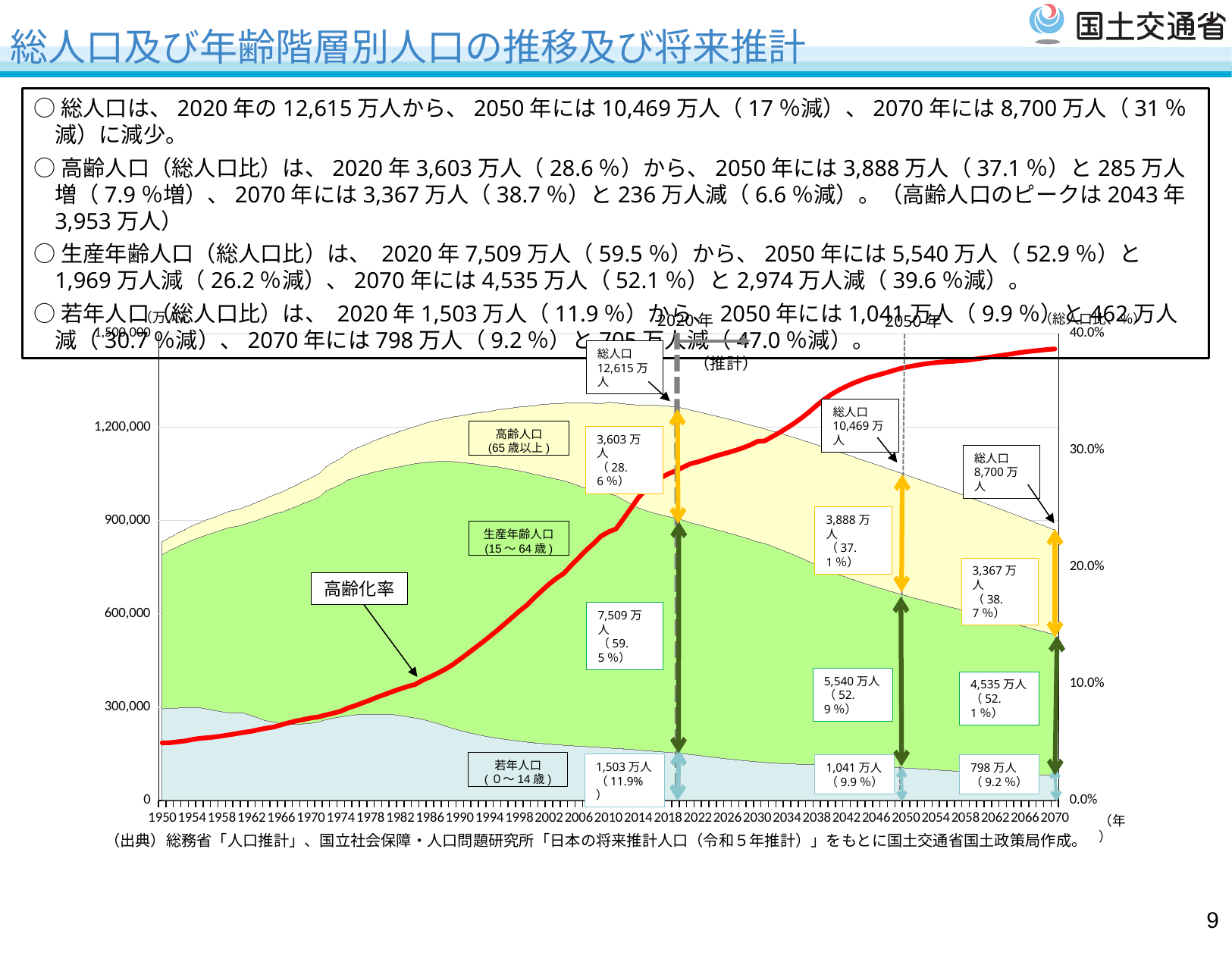
このグラフで、2070年の若年人口（0～14歳）として示されている値は何ですか？ 798万人 このグラフで、2020年から2070年にかけて生産年齢人口は増加していますか、減少していますか？ 減少 このグラフで、2050年の総人口として示されている値は何ですか？ 10,469万人 このグラフで、2070年の高齢人口（65歳以上）として示されている値は何ですか？ 3,367万人 このグラフで、2050年の生産年齢人口（15～64歳）の総人口比は何％ですか？ 52.9% このグラフで、2020年の総人口として示されている値は何ですか？ 12,615万人 このグラフで、2070年の高齢化率は30.0%より高いですか、低いですか？ 高い このグラフで、2020年の高齢人口の総人口比は何％ですか？ 28.6% このグラフで、2050年の高齢人口と2070年の高齢人口では、どちらが多いですか？ 2050年の高齢人口 このグラフで、2020年の総人口と2070年の総人口の差はいくらですか？ 3,915万人 このグラフで、2050年の高齢人口と2020年の高齢人口の差はいくらですか？ 285万人 このグラフで、高齢化率を示す赤い線は1950年から2070年にかけて上昇していますか、下降していますか？ 上昇